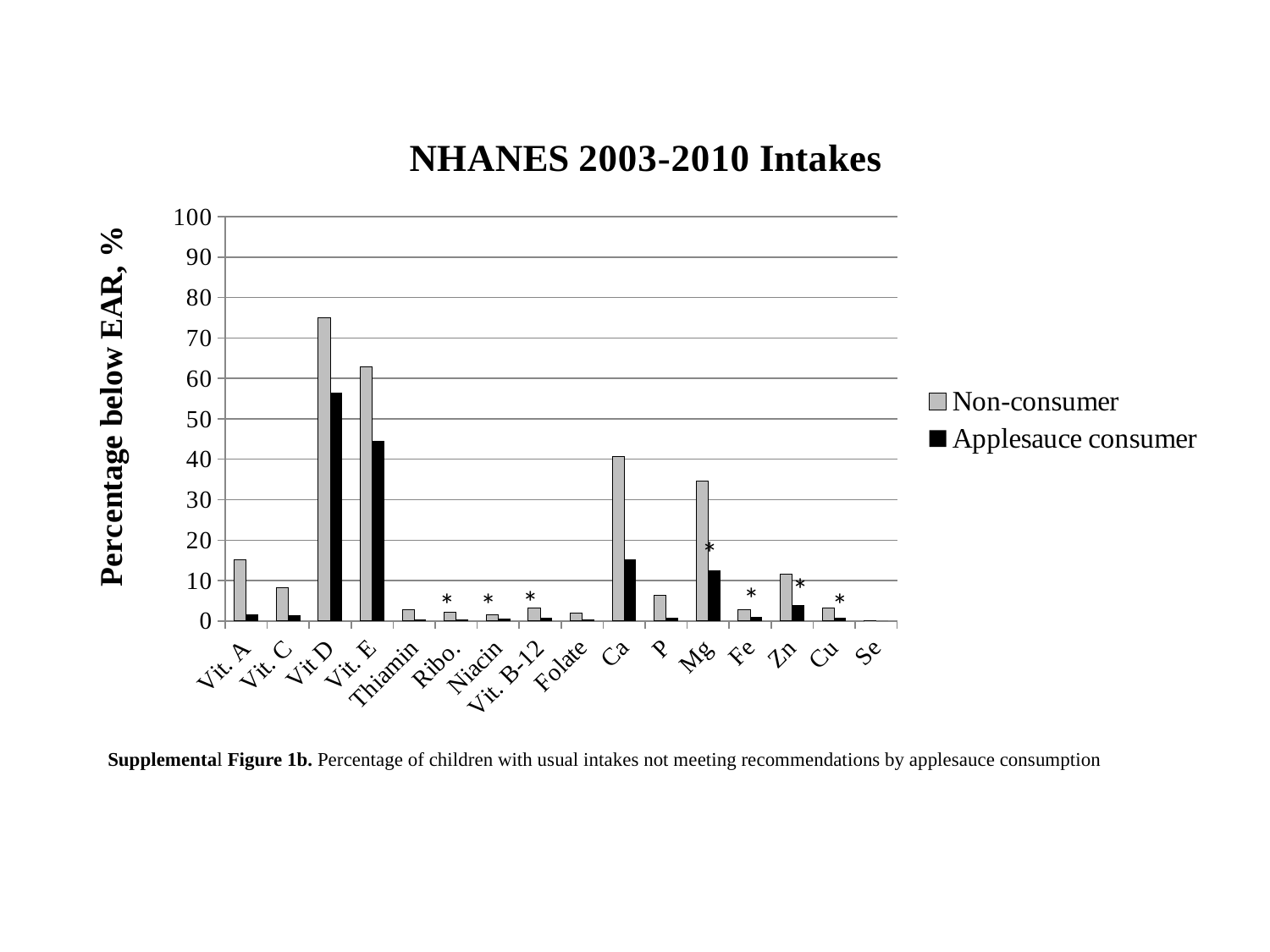
Which has the larger Non-consumer value: Ca or Mg? Ca Is the Applesauce consumer value for Vit. E greater or less than 50? less What kind of chart is shown on the slide? bar chart Which nutrient has the highest Non-consumer value? Vit D How many nutrient categories are shown on the x axis? 16 Which nutrient has the highest Applesauce consumer value? Vit D Is the Non-consumer value for Vit D greater or less than 70? greater Which is larger for Ca: the Non-consumer value or the Applesauce consumer value? Non-consumer What is the title of the chart? NHANES 2003-2010 Intakes How many series does the legend list? 2 Is the Non-consumer value for Vit. E greater or less than 60? greater